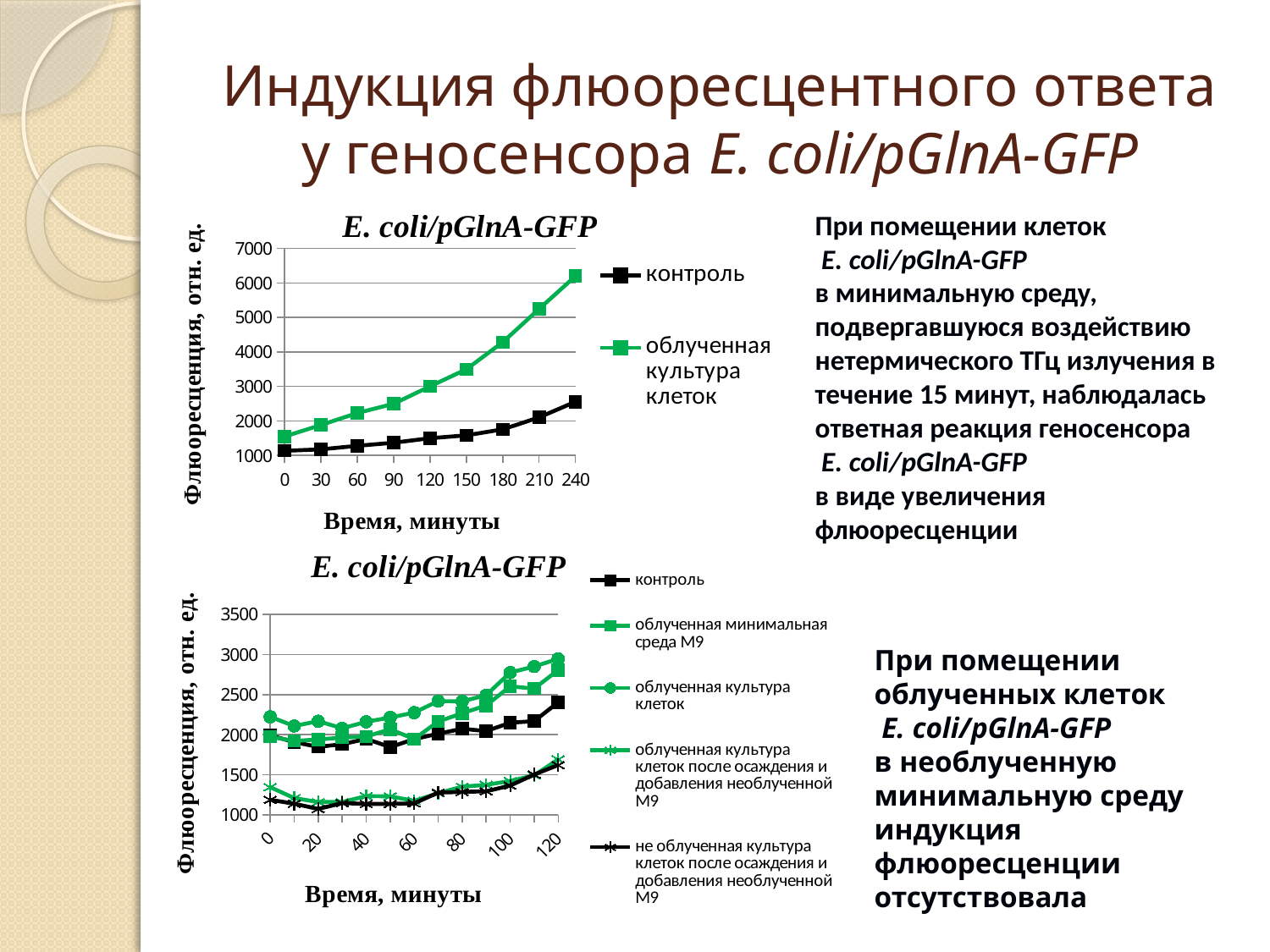
In the bottom chart, is the value for облученная культура клеток at 120 minutes greater or less than 2500? greater In the top chart, does the value for облученная культура клеток rise or fall as time increases from 0 to 240 minutes? rises In the top chart, which series has the higher value at 240 minutes, контроль or облученная культура клеток? облученная культура клеток What kind of chart is the top chart on the slide? line chart How many series does the legend of the top chart list? 2 How many time points are plotted along the x axis of the top chart? 9 In the top chart, is the value for контроль at 240 minutes greater or less than 3000? less How many series does the legend of the bottom chart list? 5 In the top chart, is the value for облученная культура клеток at 240 minutes greater or less than 5000? greater What kind of chart is the bottom chart on the slide? line chart What is the x-axis title of the bottom chart? Время, минуты What is the y-axis title of the top chart? Флюоресценция, отн. ед.